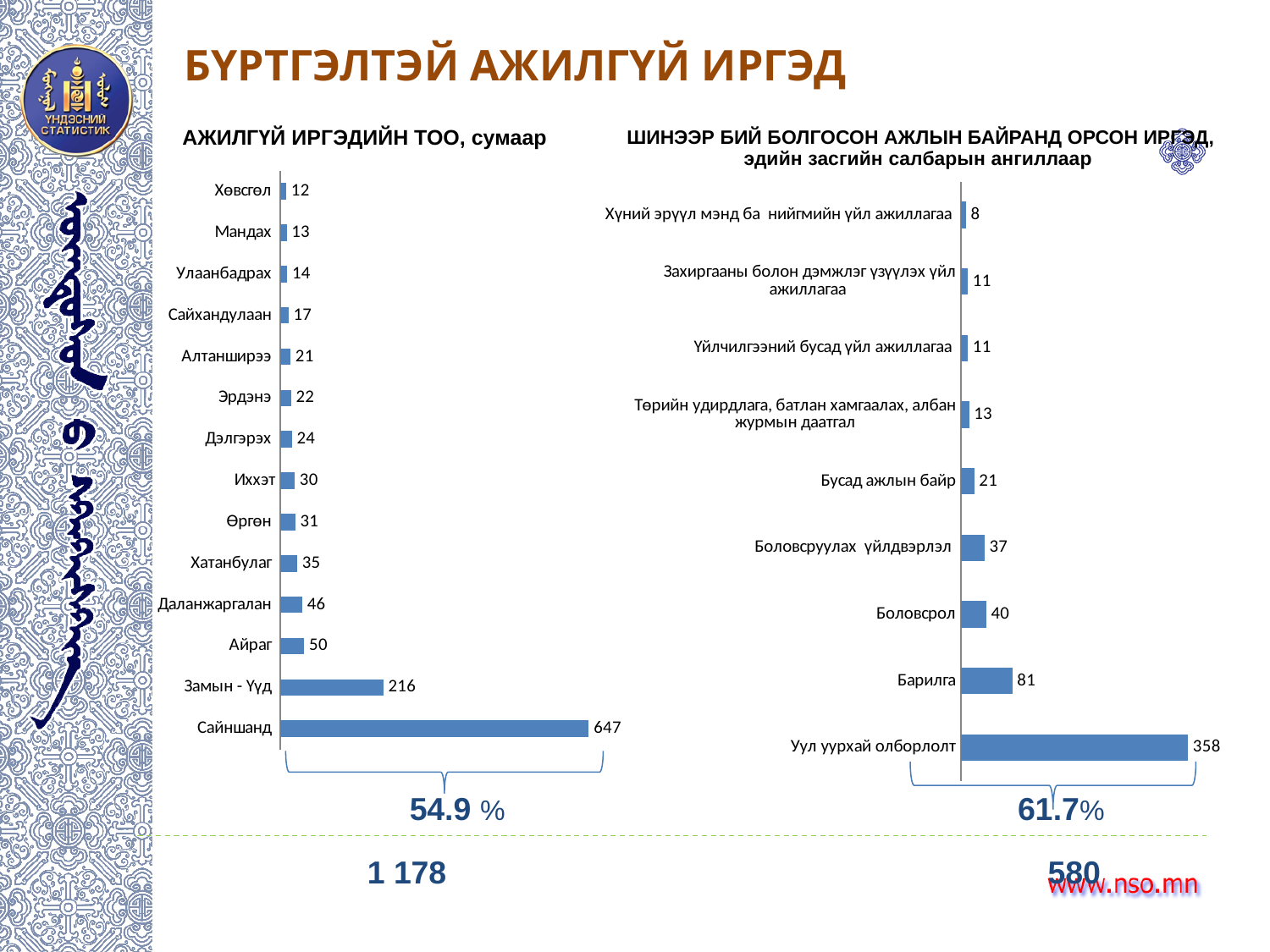
In the right chart (ШИНЭЭР БИЙ БОЛГОСОН АЖЛЫН БАЙРАНД ОРСОН ИРГЭД), what is the value for Уул уурхай олборлолт? 358 In the right chart (ШИНЭЭР БИЙ БОЛГОСОН АЖЛЫН БАЙРАНД ОРСОН ИРГЭД), which category has the highest value? Уул уурхай олборлолт In the right chart (ШИНЭЭР БИЙ БОЛГОСОН АЖЛЫН БАЙРАНД ОРСОН ИРГЭД), what is the value for Барилга? 81 In the left chart (АЖИЛГҮЙ ИРГЭДИЙН ТОО, сумаар), which category has the lowest value? Хөвсгөл In the left chart (АЖИЛГҮЙ ИРГЭДИЙН ТОО, сумаар), what is the value for Замын - Үүд? 216 In the right chart (ШИНЭЭР БИЙ БОЛГОСОН АЖЛЫН БАЙРАНД ОРСОН ИРГЭД), what is the difference between Боловсрол and Боловсруулах үйлдвэрлэл? 3 In the left chart (АЖИЛГҮЙ ИРГЭДИЙН ТОО, сумаар), what is the difference between Сайншанд and Замын - Үүд? 431 In the left chart (АЖИЛГҮЙ ИРГЭДИЙН ТОО, сумаар), what is the value for Сайншанд? 647 In the left chart (АЖИЛГҮЙ ИРГЭДИЙН ТОО, сумаар), which is larger, Айраг or Даланжаргалан? Айраг In the right chart (ШИНЭЭР БИЙ БОЛГОСОН АЖЛЫН БАЙРАНД ОРСОН ИРГЭД), how many categories are shown? 9 What type of chart is the right chart (ШИНЭЭР БИЙ БОЛГОСОН АЖЛЫН БАЙРАНД ОРСОН ИРГЭД)? Bar chart In the left chart (АЖИЛГҮЙ ИРГЭДИЙН ТОО, сумаар), how many categories are shown? 14